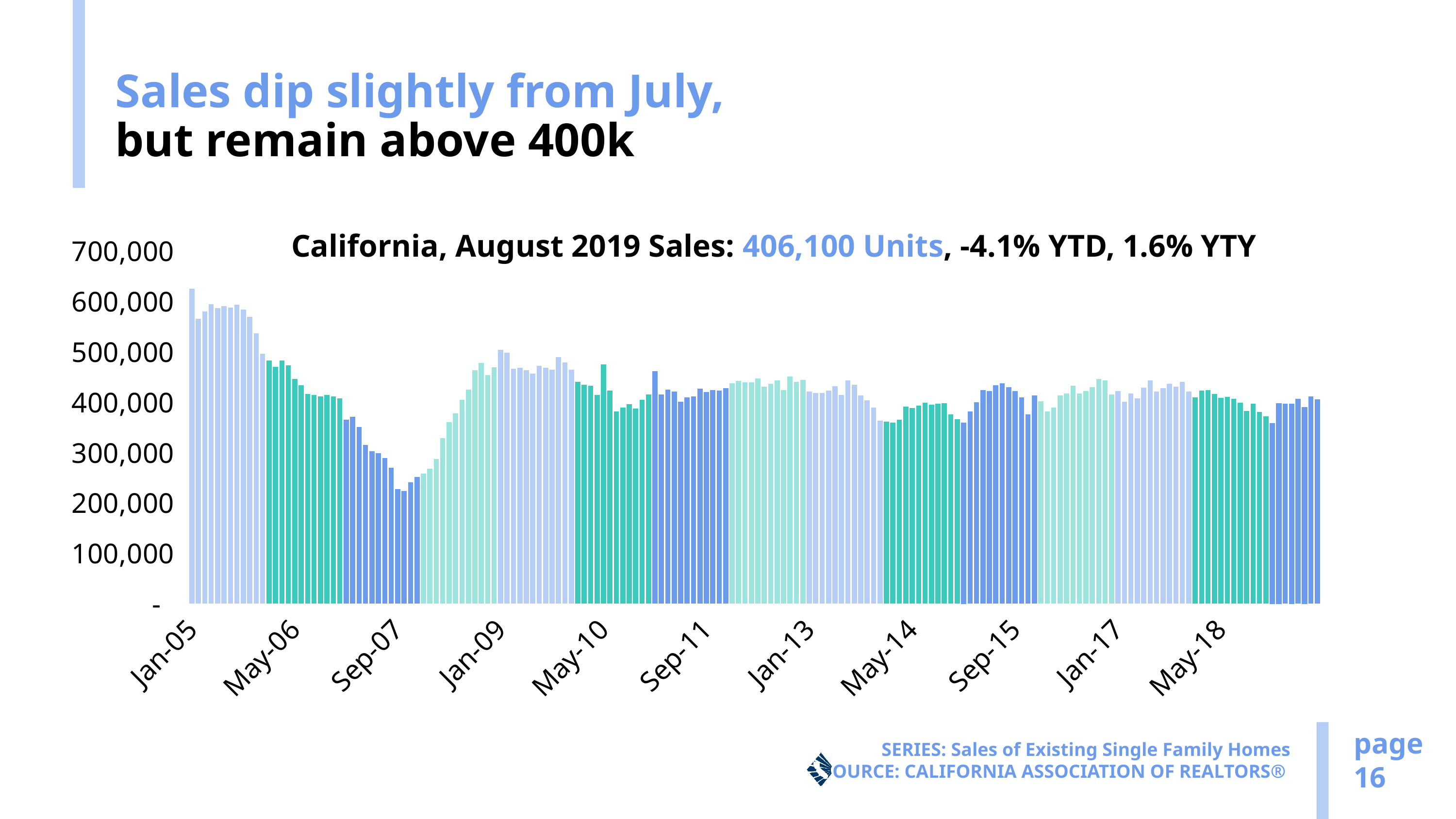
What is the year-to-date (YTD) change stated in the chart title? -4.1% Which of the labeled months on the x axis has the lowest value? Sep-07 What is the highest value shown on the vertical axis? 700,000 What is the year-to-year (YTY) change stated in the chart title? 1.6% Is the value for Sep-07 greater or less than 300,000? less According to the chart title, how many units were sold in California in August 2019? 406,100 Units Is the value for Jan-09 greater or less than 400,000? greater Which is larger, the value for Jan-05 or the value for Sep-07? Jan-05 Which of the labeled months on the x axis has the highest value? Jan-05 Do the values rise or fall from Jan-05 to Sep-07? fall What kind of chart is shown on the slide? bar chart Is the value for Jan-05 greater or less than 600,000? greater